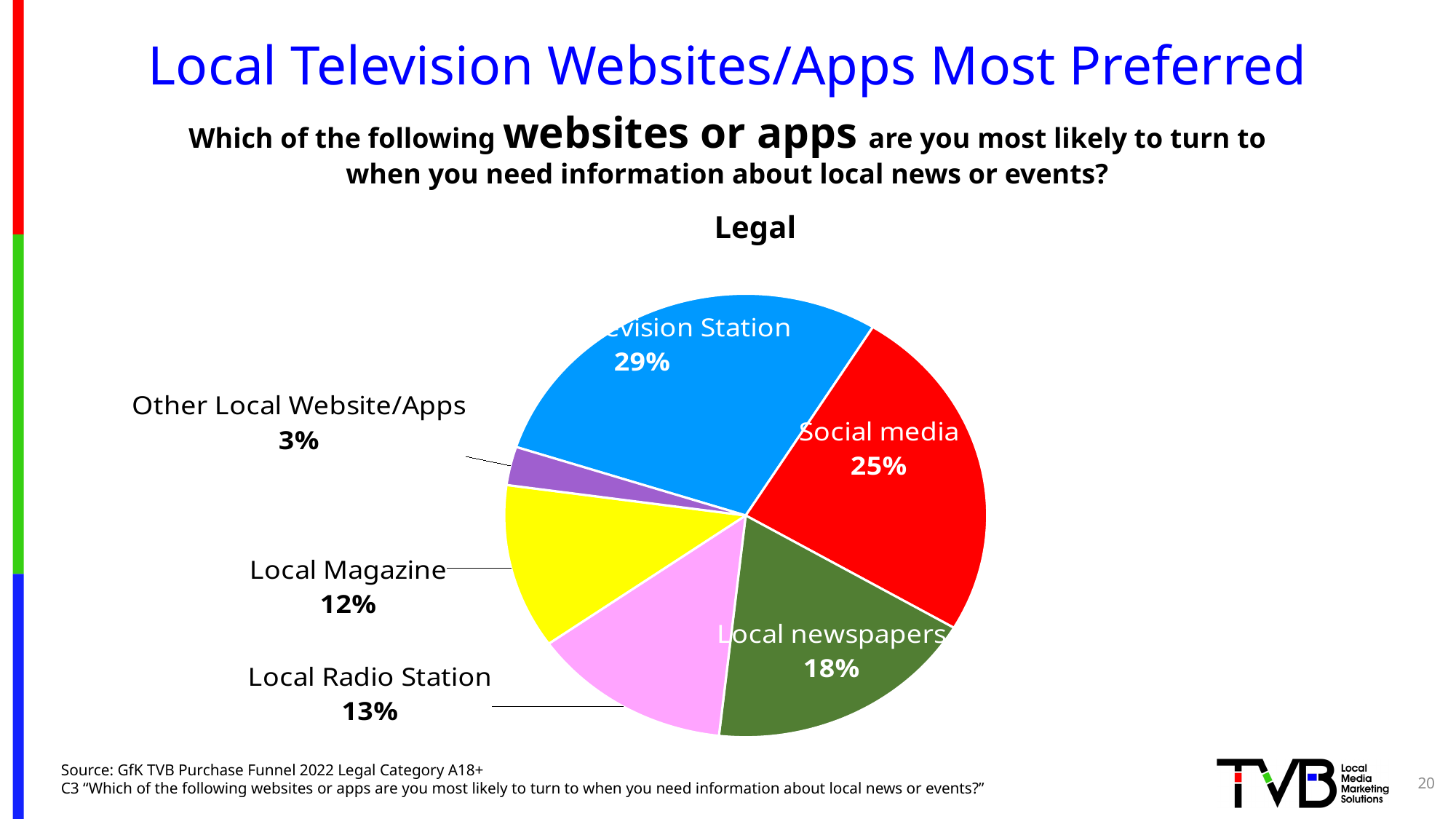
What is the difference between the Social media and Local newspapers percentages? 7% What kind of chart is shown on the slide? pie chart What is the percentage of the largest slice in the pie chart? 29% What percentage is shown for Local Radio Station? 13% What percentage is shown for Local newspapers? 18% What percentage is shown for Other Local Website/Apps? 3% Which is larger, Local Radio Station or Local Magazine? Local Radio Station What percentage is shown for Social media? 25% What is the title of the chart? Legal Which category has the smallest slice? Other Local Website/Apps What percentage is shown for Local Magazine? 12% How many slices does the pie chart have? 6